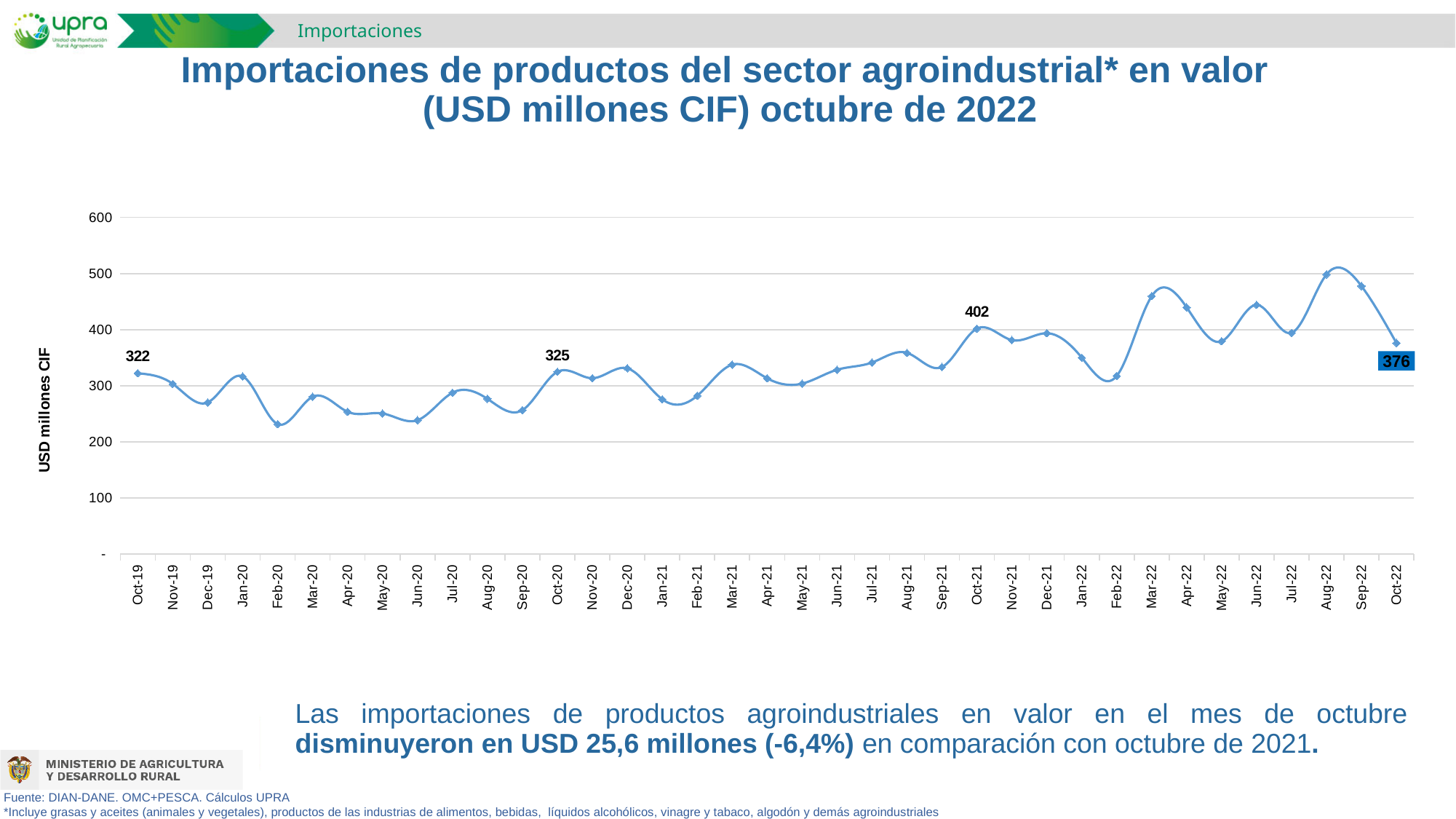
What kind of chart is shown on the slide? line chart What is the value for Oct-21? 402 What is the value for Oct-20? 325 What is the difference between the values for Oct-21 and Oct-22? 26 How many monthly data points are plotted on the chart? 37 Is the value for Feb-20 greater or less than 300? less What is the label of the vertical axis? USD millones CIF Is the value for Mar-22 greater or less than 400? greater Which month has the highest value on the chart? Aug-22 What is the value for Oct-19? 322 What is the value for Oct-22? 376 Which is larger, the value for Oct-21 or the value for Oct-22? Oct-21